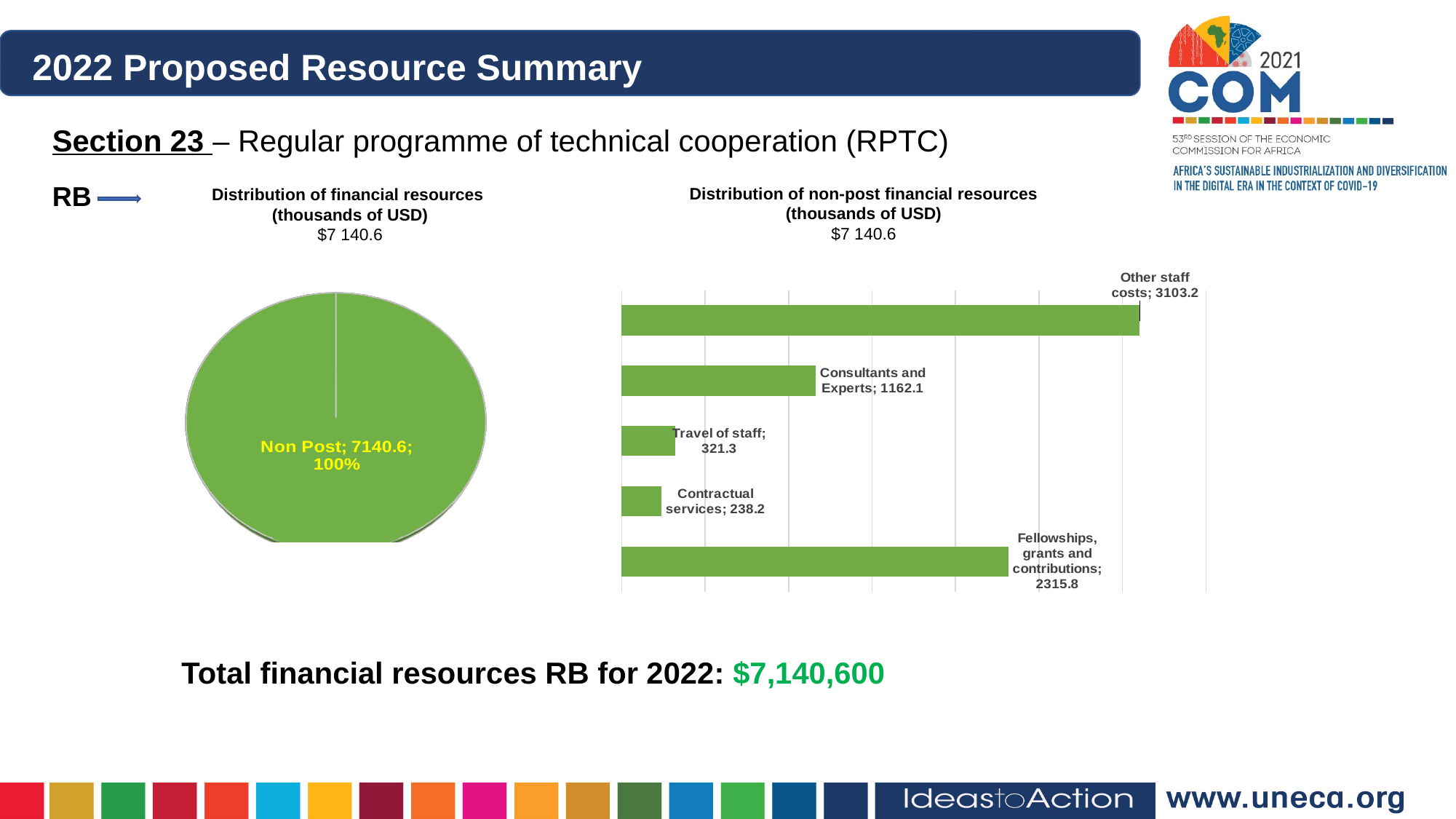
How many categories are shown in the 'Distribution of non-post financial resources' chart? 5 In the 'Distribution of non-post financial resources' chart, what is the value for Other staff costs? 3103.2 In the 'Distribution of financial resources' pie chart, what is the value for Non Post? 7140.6 In the 'Distribution of non-post financial resources' chart, what is the value for Travel of staff? 321.3 In the 'Distribution of non-post financial resources' chart, what is the difference between Other staff costs and Fellowships, grants and contributions? 787.4 In the 'Distribution of non-post financial resources' chart, what is the value for Fellowships, grants and contributions? 2315.8 In the 'Distribution of non-post financial resources' chart, what is the value for Consultants and Experts? 1162.1 In the 'Distribution of non-post financial resources' chart, which category has the highest value? Other staff costs In the 'Distribution of non-post financial resources' chart, which is larger: Consultants and Experts or Travel of staff? Consultants and Experts In the 'Distribution of financial resources' pie chart, what share does Non Post represent? 100% What kind of chart is the 'Distribution of non-post financial resources' chart? Bar chart In the 'Distribution of non-post financial resources' chart, which category has the lowest value? Contractual services